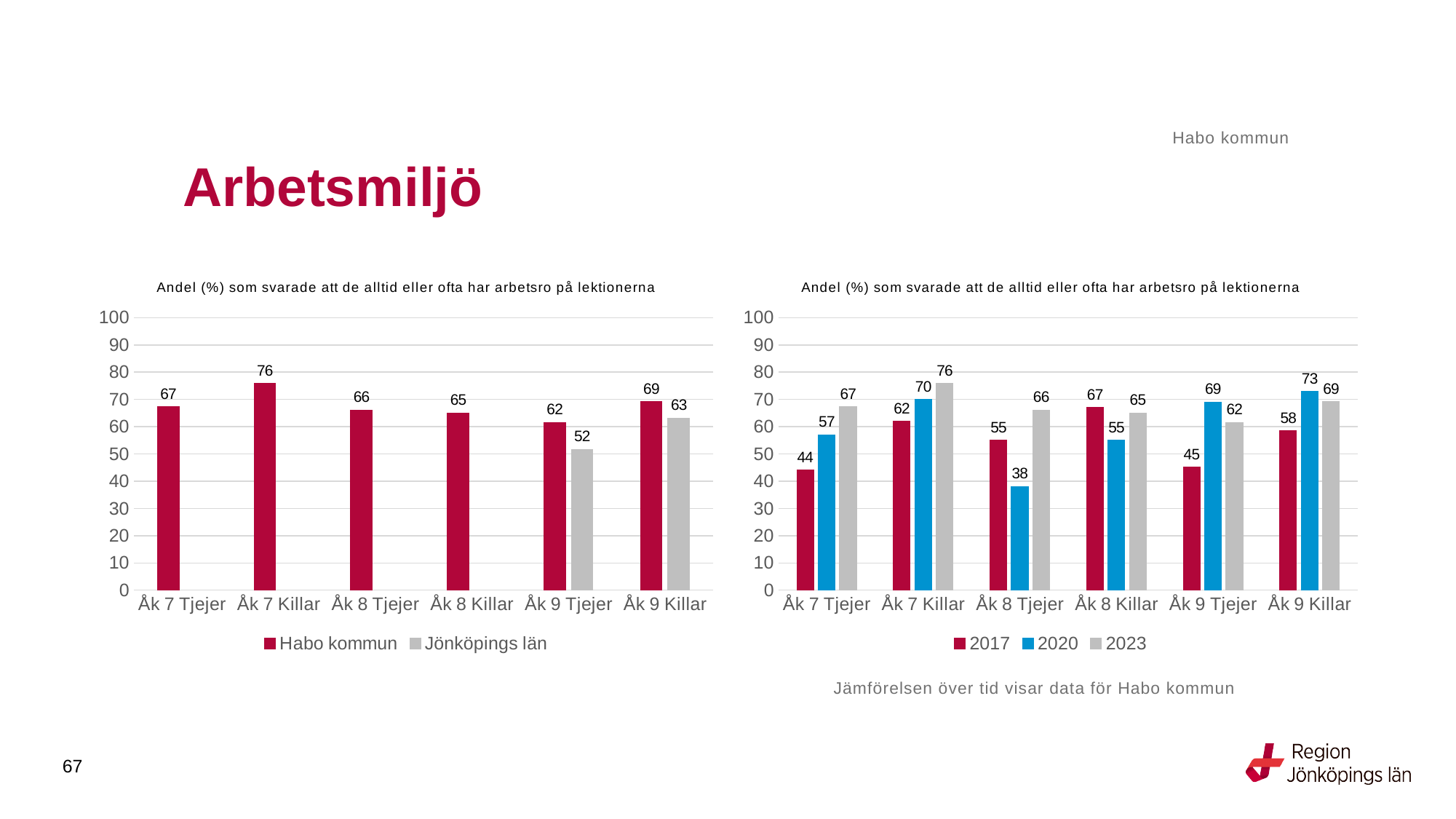
In the right chart, what is the value for 2017 for Åk 9 Tjejer? 45 In the right chart, how many series does the legend list? 3 In the left chart, what is the difference between Habo kommun and Jönköpings län for Åk 9 Killar? 6 In the left chart, what is the value for Jönköpings län for Åk 9 Tjejer? 52 In the right chart, which category has the lowest value for 2017? Åk 7 Tjejer In the left chart, which category has the highest value for Habo kommun? Åk 7 Killar In the right chart, what is the difference between the 2023 and 2017 values for Åk 7 Tjejer? 23 In the left chart, how many series does the legend list? 2 In the left chart, what is the value for Habo kommun for Åk 7 Killar? 76 In the right chart, what is the value for 2020 for Åk 8 Tjejer? 38 In the right chart, which is larger for Åk 8 Killar: the 2017 value or the 2020 value? 2017 What kind of chart is the right chart? Bar chart